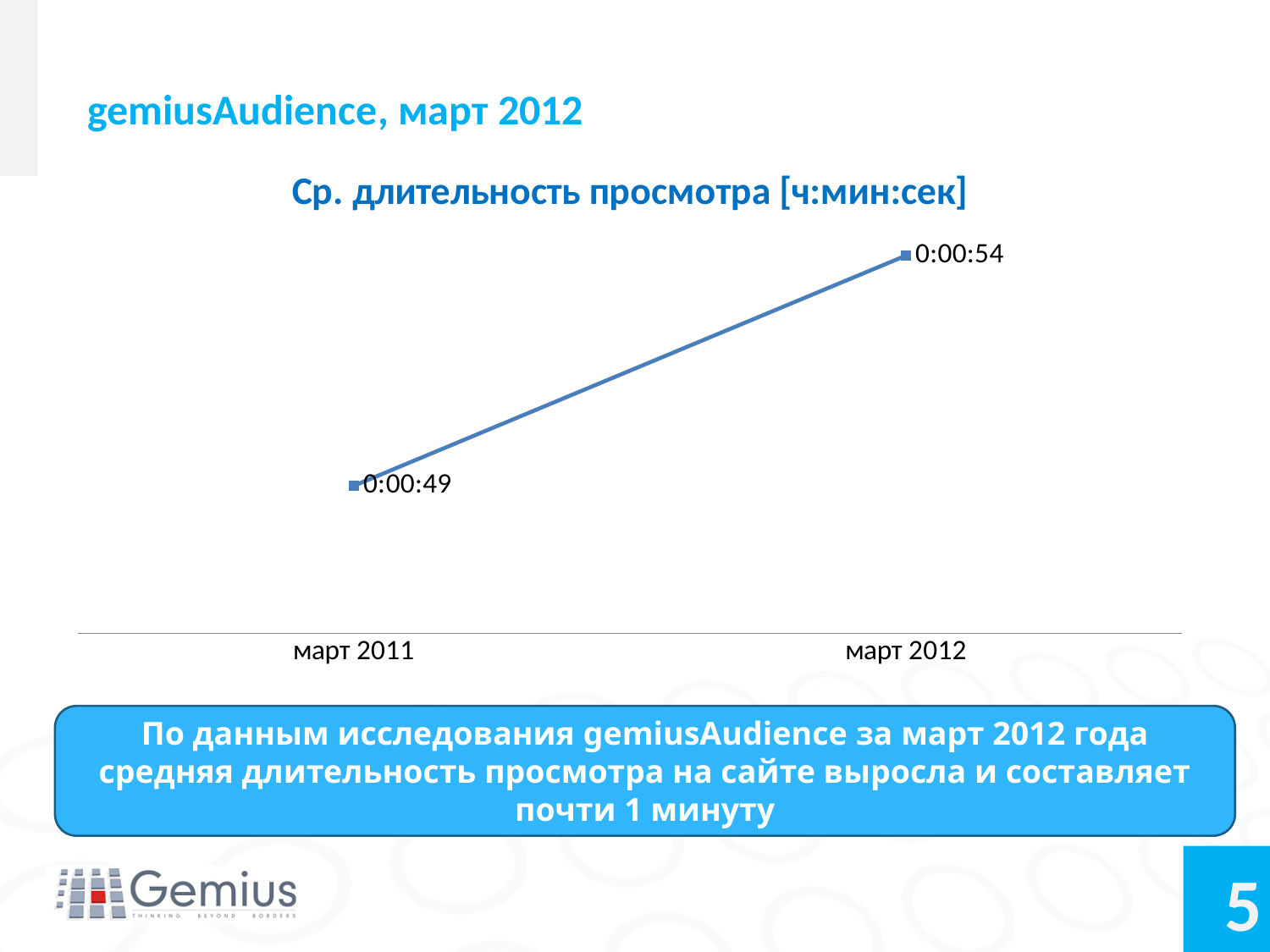
Does the average viewing duration rise or fall from март 2011 to март 2012? rise What kind of chart is shown on the slide? line chart What colour is the line on the chart? blue Is the value for март 2012 larger or smaller than the value for март 2011? larger What is the title of the chart? Ср. длительность просмотра [ч:мин:сек] By how many seconds did the average viewing duration increase from март 2011 to март 2012? 5 seconds Which period has the lower average viewing duration? март 2011 What is the average viewing duration for март 2012? 0:00:54 How many data points are plotted on the chart? 2 Which period has the higher average viewing duration? март 2012 What is the average viewing duration for март 2011? 0:00:49